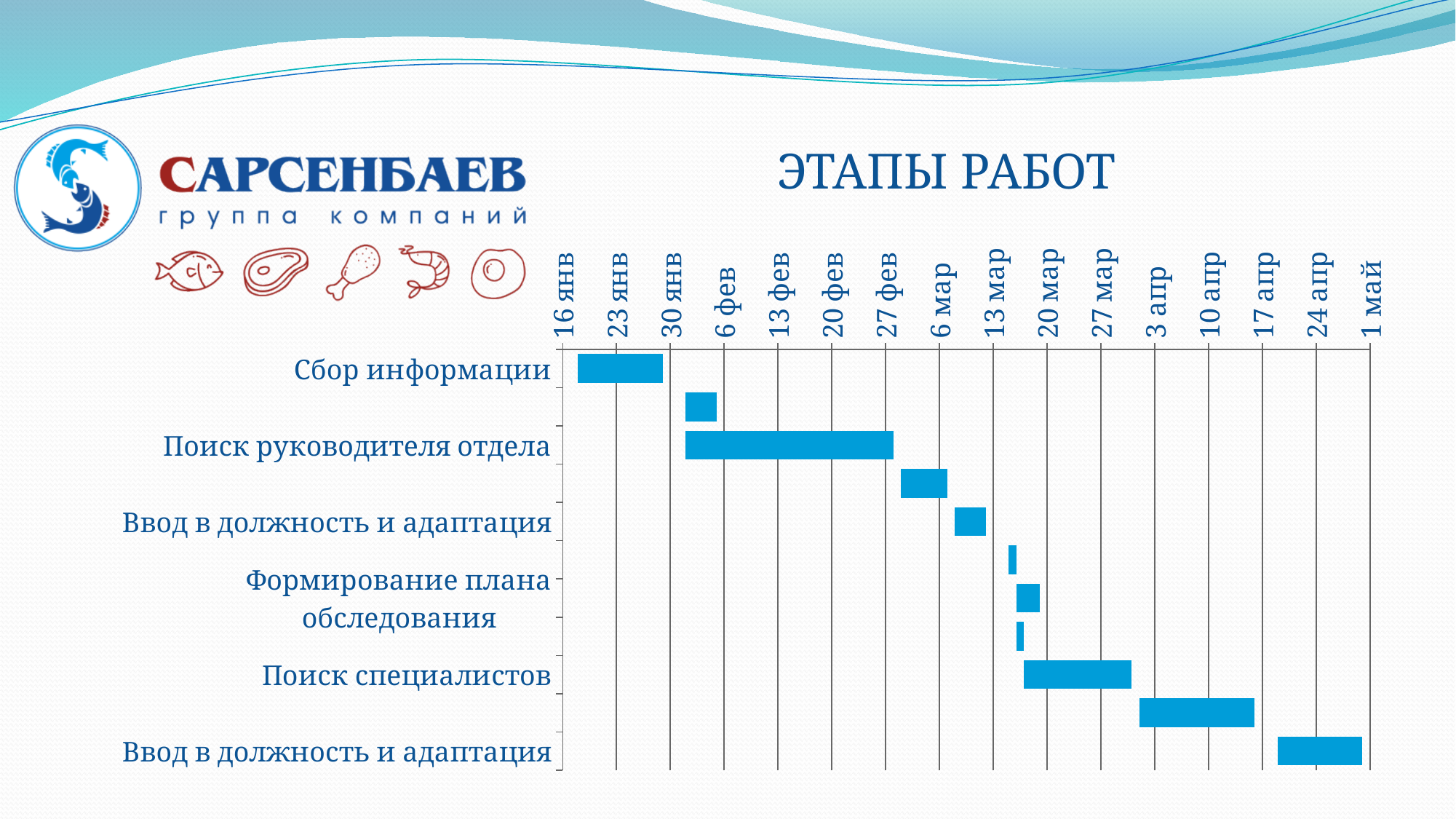
Which bar is longer: 'Сбор информации' or 'Поиск специалистов'? Поиск специалистов What kind of chart is shown on the slide? Bar chart (Gantt chart) How many task labels are listed on the vertical axis? 6 Which labeled task is scheduled first on the timeline? Сбор информации What is the last date label on the x axis? 1 май What is the title of the chart? ЭТАПЫ РАБОТ Which labeled task has the longest bar? Поиск руководителя отдела How many date labels are shown along the x axis? 16 What is the first date label on the x axis? 16 янв